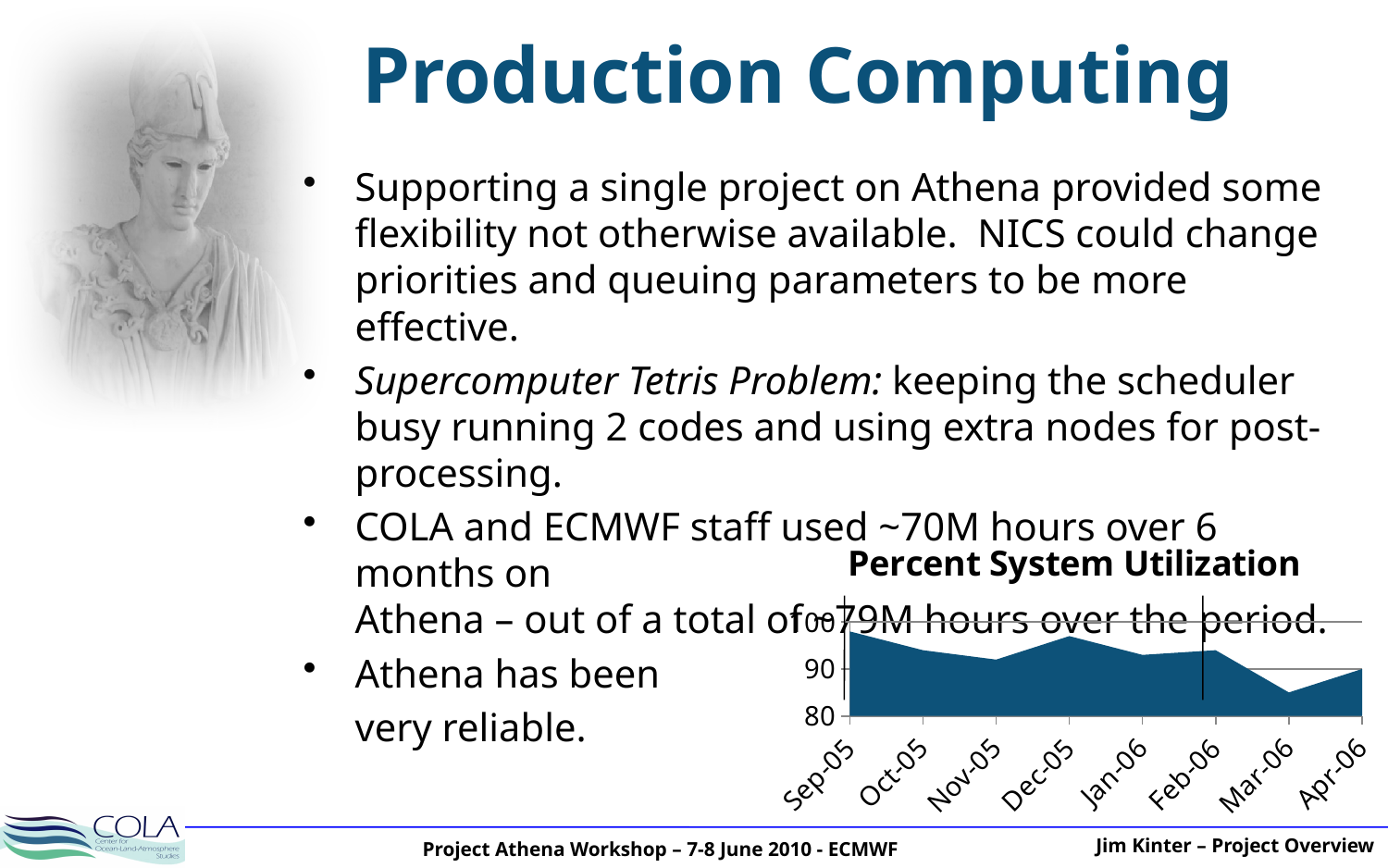
Which month has the highest system utilization? Sep-05 What is the first month shown on the x axis? Sep-05 Which month has the lowest system utilization? Mar-06 Is the value for Mar-06 greater or less than 90? less Is the value for Sep-05 greater or less than 90? greater Is the value for Oct-05 greater or less than 100? less Which is larger, the value for Sep-05 or the value for Mar-06? Sep-05 What is the title of the chart? Percent System Utilization Does system utilization generally rise or fall from Sep-05 to Apr-06? fall How many months are shown on the x axis of the chart? 8 What kind of chart is shown on the slide? area chart